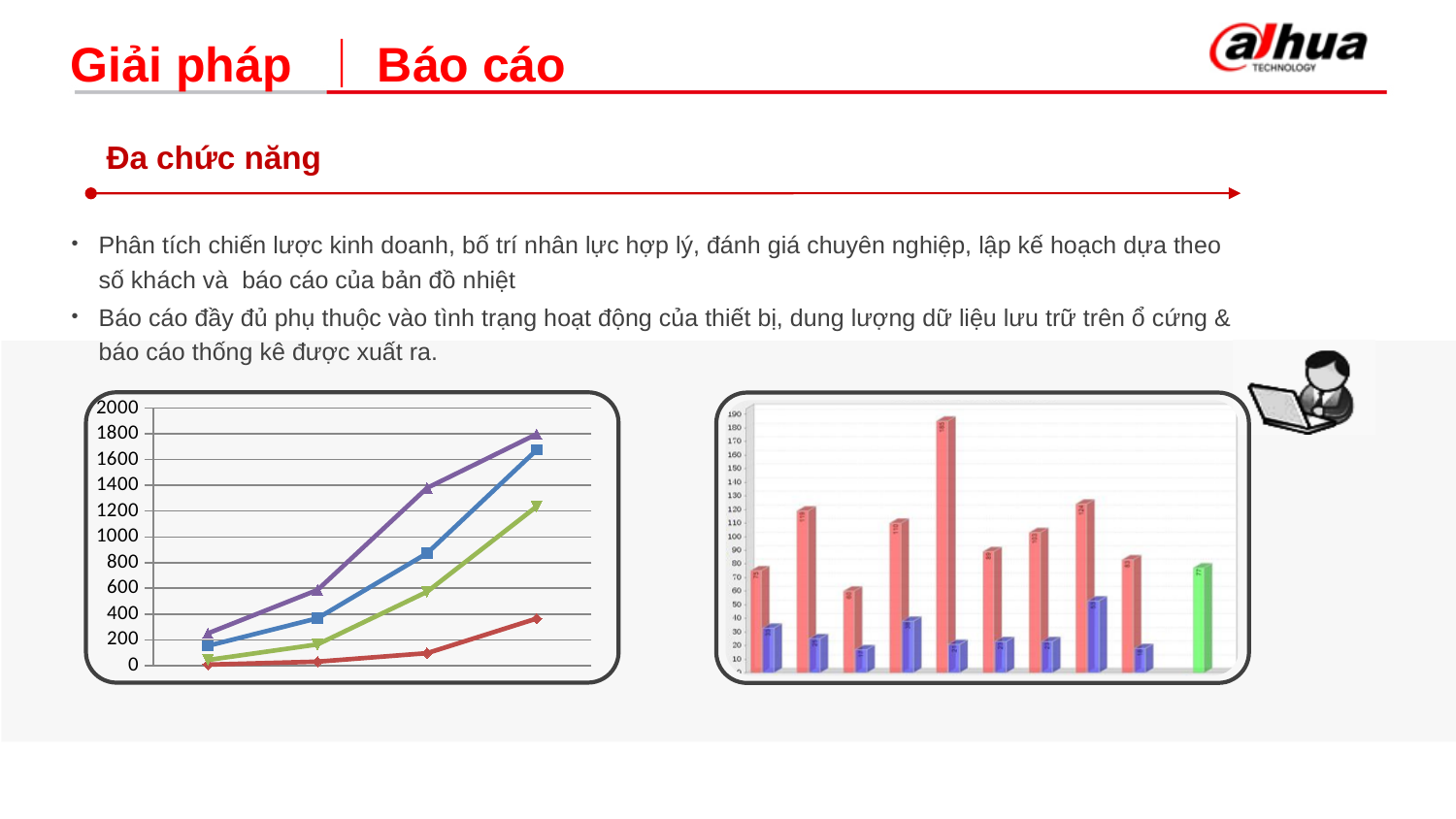
In the chart on the left, how many data points does each line have? 4 In the chart on the left, which line is highest at the rightmost point? the purple line In the chart on the left, is the rightmost value of the green line greater or less than 1000? greater In the chart on the left, is the rightmost value of the red line greater or less than 600? less What kind of chart is the chart on the left of the slide? line chart In the chart on the left, which line is lowest at the rightmost point? the red line In the chart on the left, what is the highest value shown on the vertical axis? 2000 In the chart on the left, do the values of the lines rise or fall from left to right? rise What kind of chart is the chart on the right of the slide? bar chart In the chart on the left, is the rightmost value of the purple line greater or less than 1600? greater In the chart on the left, how many lines are plotted? 4